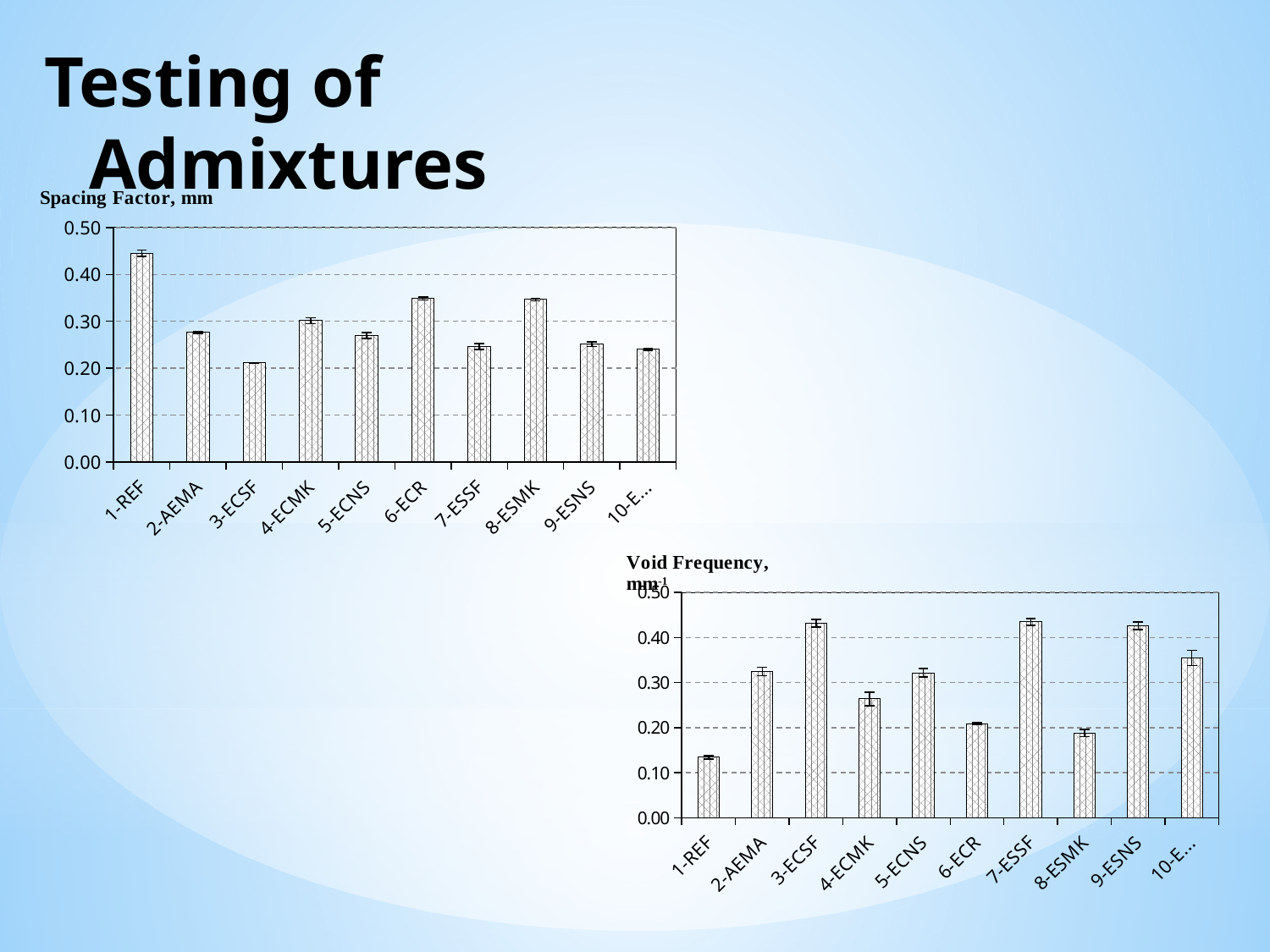
In the Void Frequency chart, is the value for 1-REF greater or less than 0.20? less In the Spacing Factor, mm chart, which is larger, the value for 1-REF or the value for 2-AEMA? 1-REF In the Void Frequency chart, which is larger, the value for 3-ECSF or the value for 4-ECMK? 3-ECSF What kind of chart is the Void Frequency chart? bar chart In the Void Frequency chart, which category has the lowest value? 1-REF In the Void Frequency chart, is the value for 2-AEMA greater or less than 0.30? greater In the Void Frequency chart, is the value for 3-ECSF greater or less than 0.40? greater In the Spacing Factor, mm chart, which category has the lowest value? 3-ECSF How many categories are shown on the x axis of the Spacing Factor, mm chart? 10 In the Spacing Factor, mm chart, which category has the highest value? 1-REF